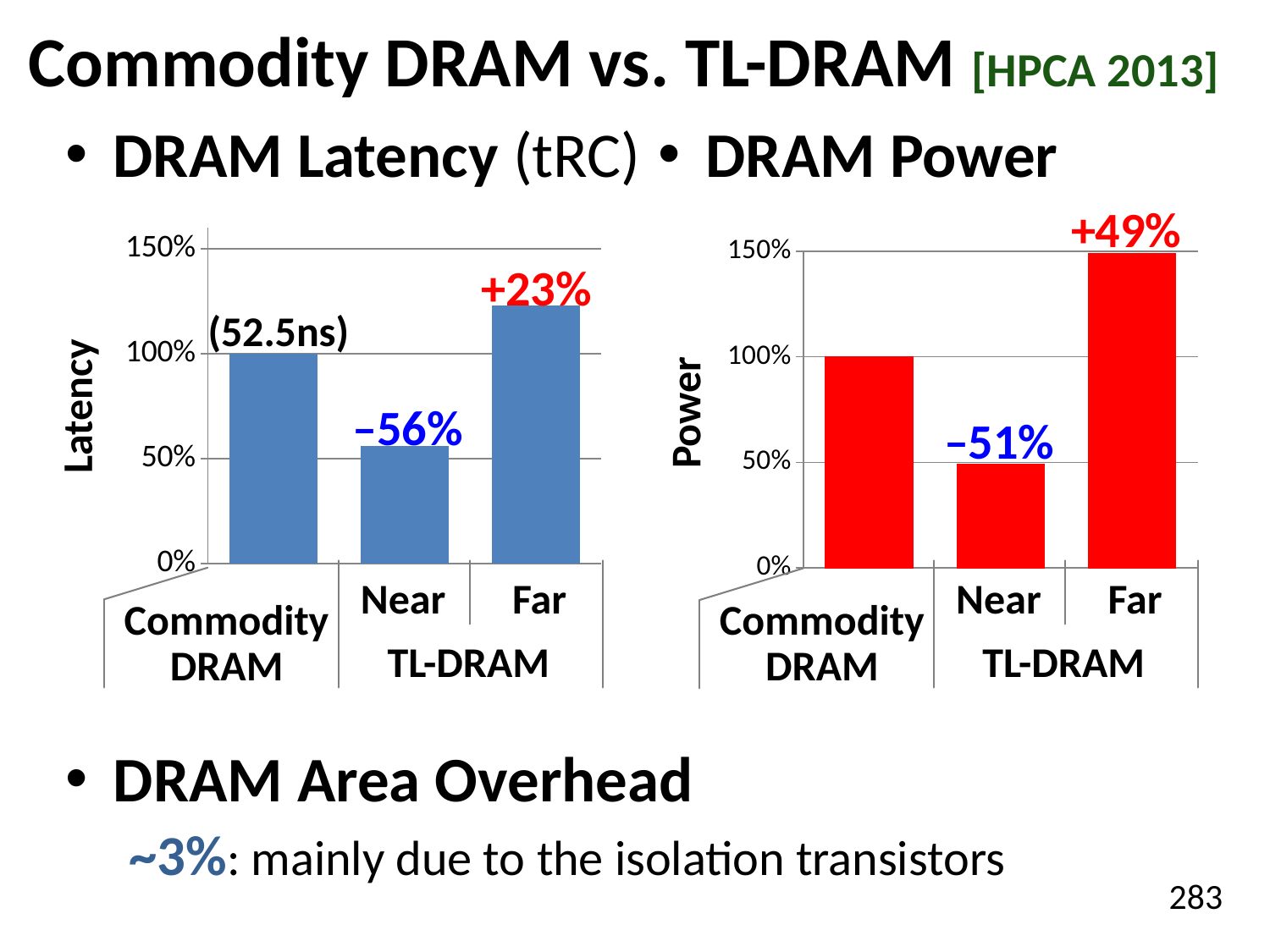
In the DRAM Power chart, is the value for Far greater or less than 100%? greater In the DRAM Power chart, what percentage change is labelled on the Far bar? +49% In the DRAM Latency chart, which bar is the highest? Far In the DRAM Latency chart, what percentage change is labelled on the Far bar? +23% In the DRAM Power chart, what percentage change is labelled on the Near bar? –51% How many bars are plotted in the DRAM Power chart? 3 In the DRAM Power chart, which bar is the lowest? Near In the DRAM Latency chart, what absolute latency is noted for Commodity DRAM? 52.5ns In the DRAM Latency chart, what percentage change is labelled on the Near bar? –56% What type of chart is the DRAM Latency chart? bar chart In the DRAM Latency chart, is the value for Near greater or less than 50%? greater In the DRAM Latency chart, what value does the Commodity DRAM bar reach? 100%